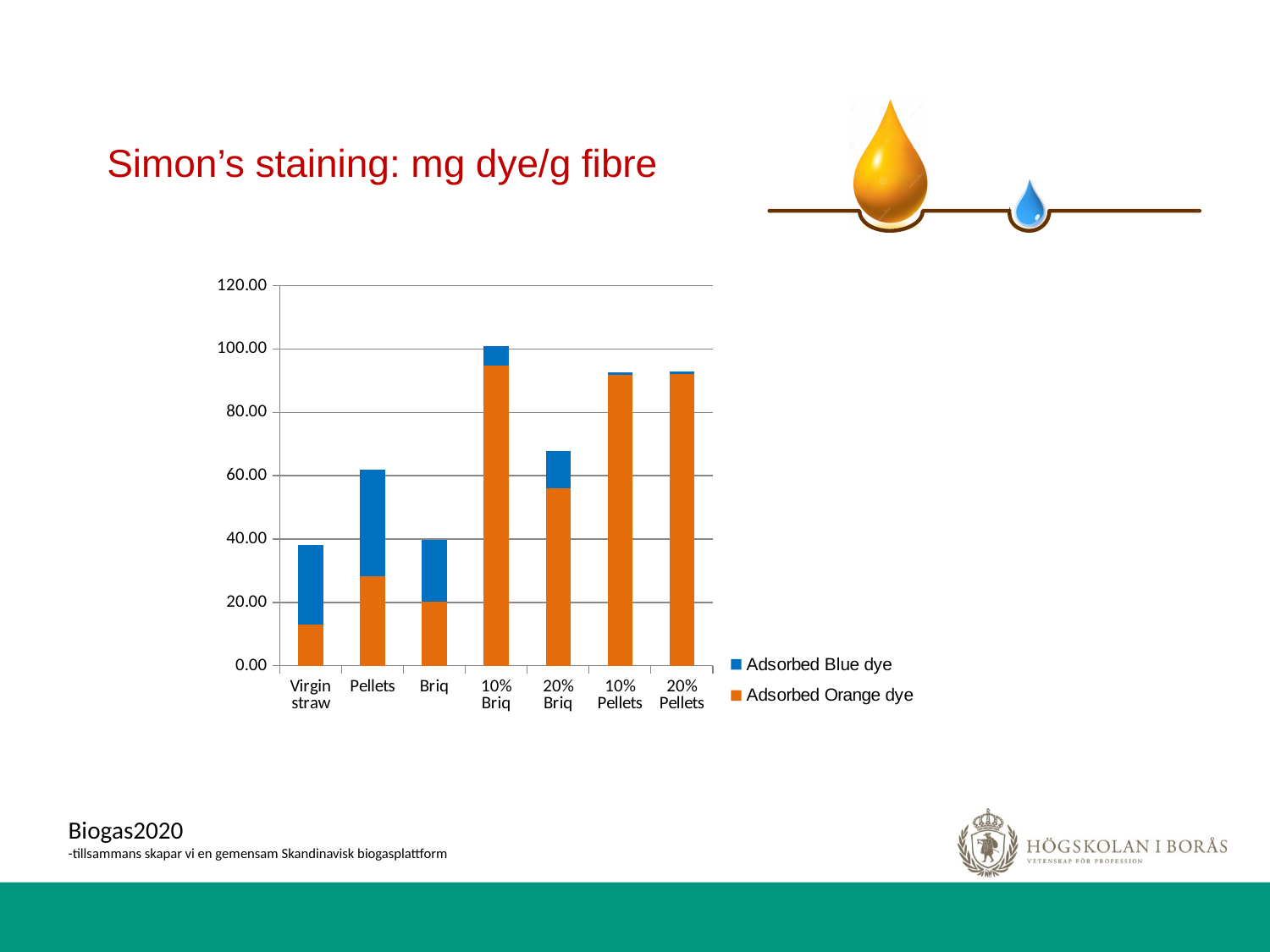
Which category has the lowest value for Adsorbed Orange dye? Virgin straw What colour represents Adsorbed Blue dye in the legend? Blue Is the total stacked value for 10% Pellets greater or less than 100.00? less What kind of chart is shown on the slide? Stacked bar chart Is the total stacked value for Pellets greater or less than 60.00? greater How many series does the legend list? 2 How many categories are shown on the x axis? 7 Which category has the highest total stacked bar? 10% Briq Is the Adsorbed Orange dye value for Virgin straw greater or less than 20.00? less Which has the larger Adsorbed Orange dye value, 10% Briq or 20% Briq? 10% Briq Which has the larger total stacked bar, Pellets or Briq? Pellets